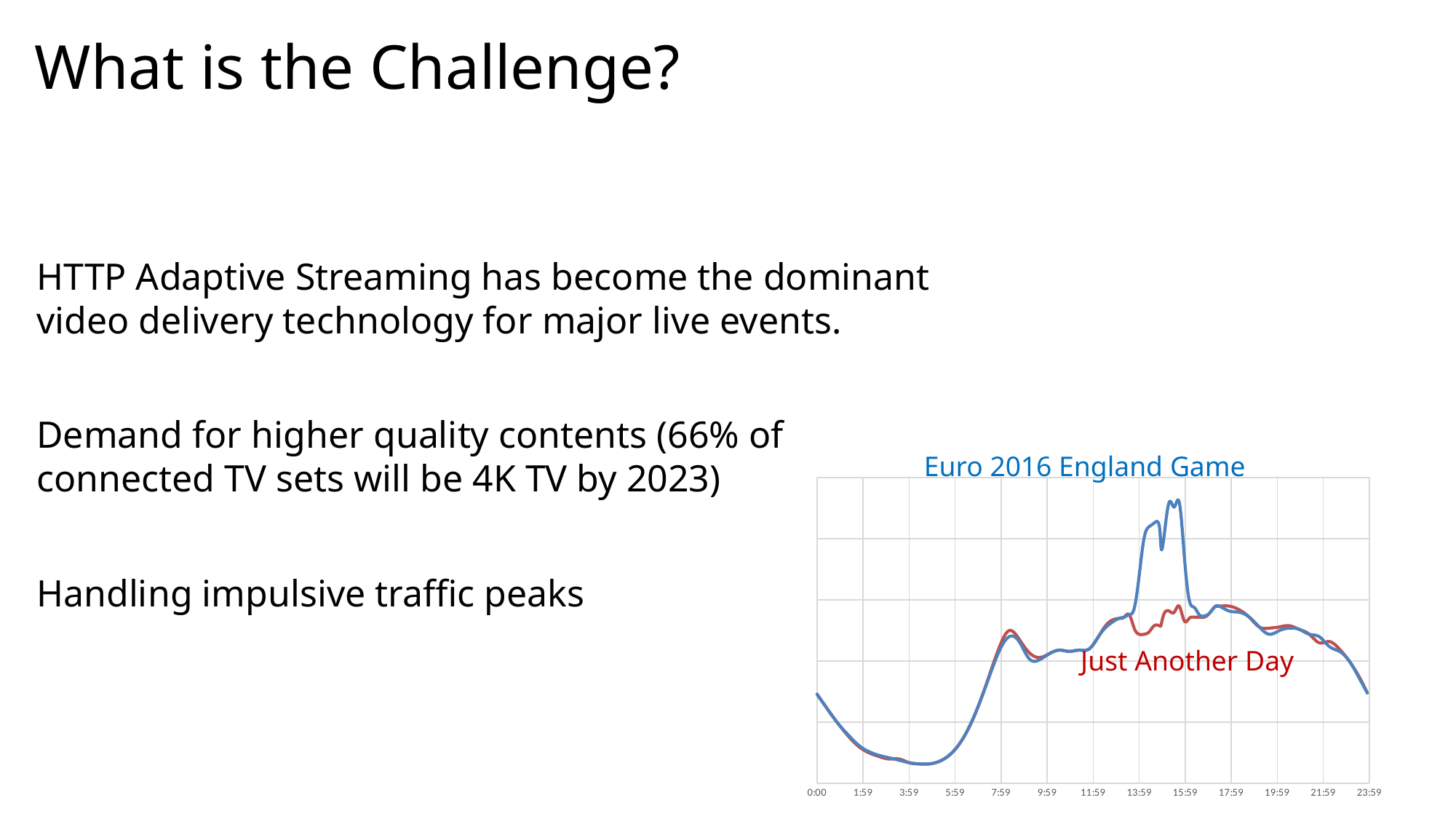
Around what time of day does the Euro 2016 England Game series reach its highest point? between 13:59 and 15:59 Which series reaches the higher peak between 13:59 and 15:59, Euro 2016 England Game or Just Another Day? Euro 2016 England Game Around what time of day do both series reach their lowest point? between 3:59 and 5:59 Which colour is used for the Euro 2016 England Game series? blue What kind of chart is shown on the slide? line chart What is the last time label on the x axis? 23:59 Do the values rise or fall between 0:00 and 3:59? fall How many series are plotted on the chart? 2 Do the values rise or fall between 21:59 and 23:59? fall Do the values rise or fall between 5:59 and 7:59? rise What are the names of the two series plotted on the chart? Euro 2016 England Game and Just Another Day How many time labels are shown on the x axis? 13